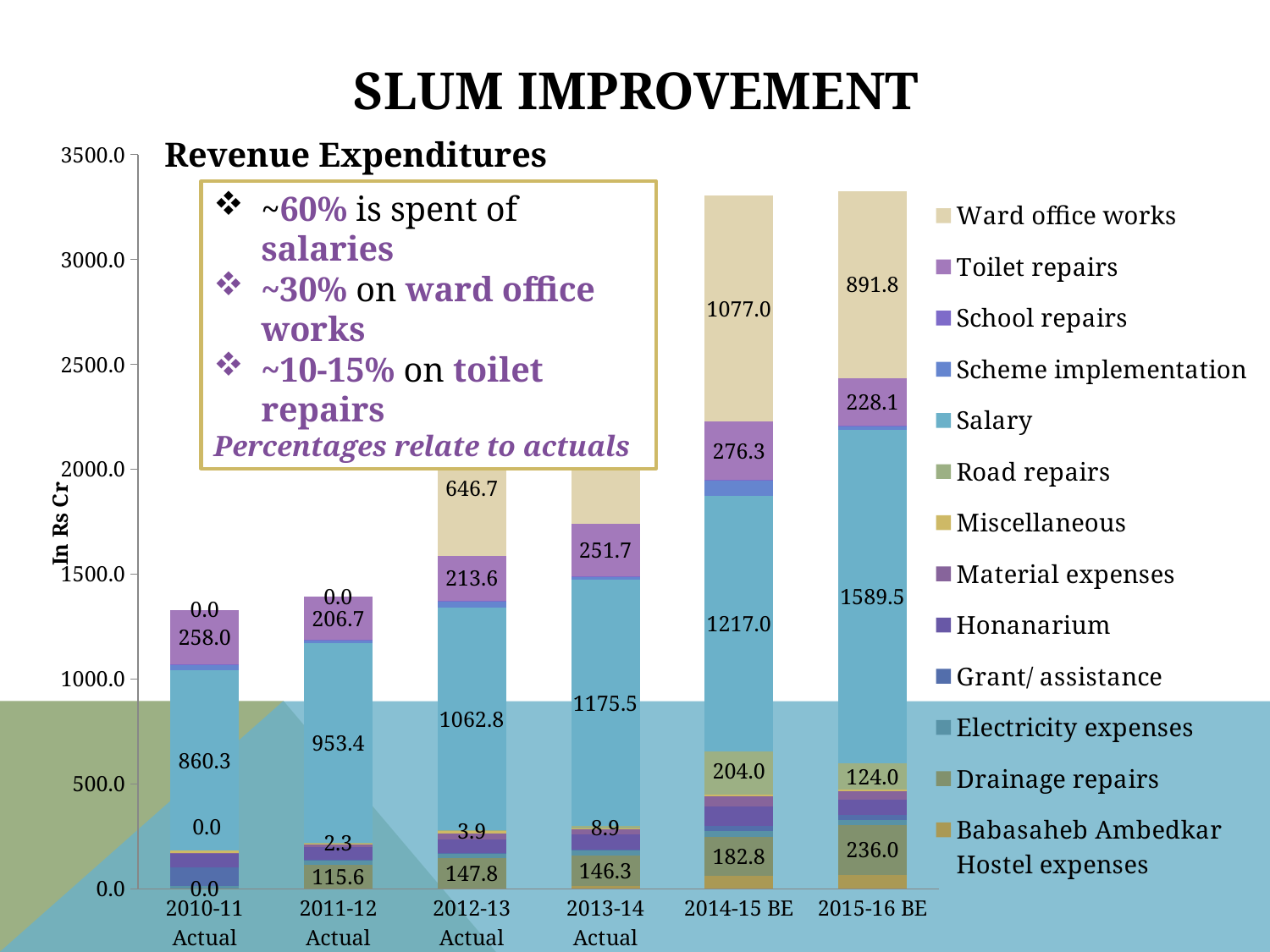
What is the Ward office works value for 2014-15 BE? 1077.0 What is the Salary value for 2015-16 BE? 1589.5 What is the difference between the Salary values for 2015-16 BE and 2014-15 BE? 372.5 What is the Toilet repairs value for 2013-14 Actual? 251.7 How many series does the legend list? 13 Which year has the lowest Toilet repairs value? 2011-12 Actual Does the Salary value rise or fall from 2010-11 Actual to 2015-16 BE? Rise Is the total height of the 2014-15 BE bar greater or less than 3000.0? greater Which year has the highest Salary value? 2015-16 BE What kind of chart is shown on the slide? Stacked bar chart How many years (categories) are shown on the x axis? 6 Which is larger, the Toilet repairs value for 2014-15 BE or for 2011-12 Actual? 2014-15 BE